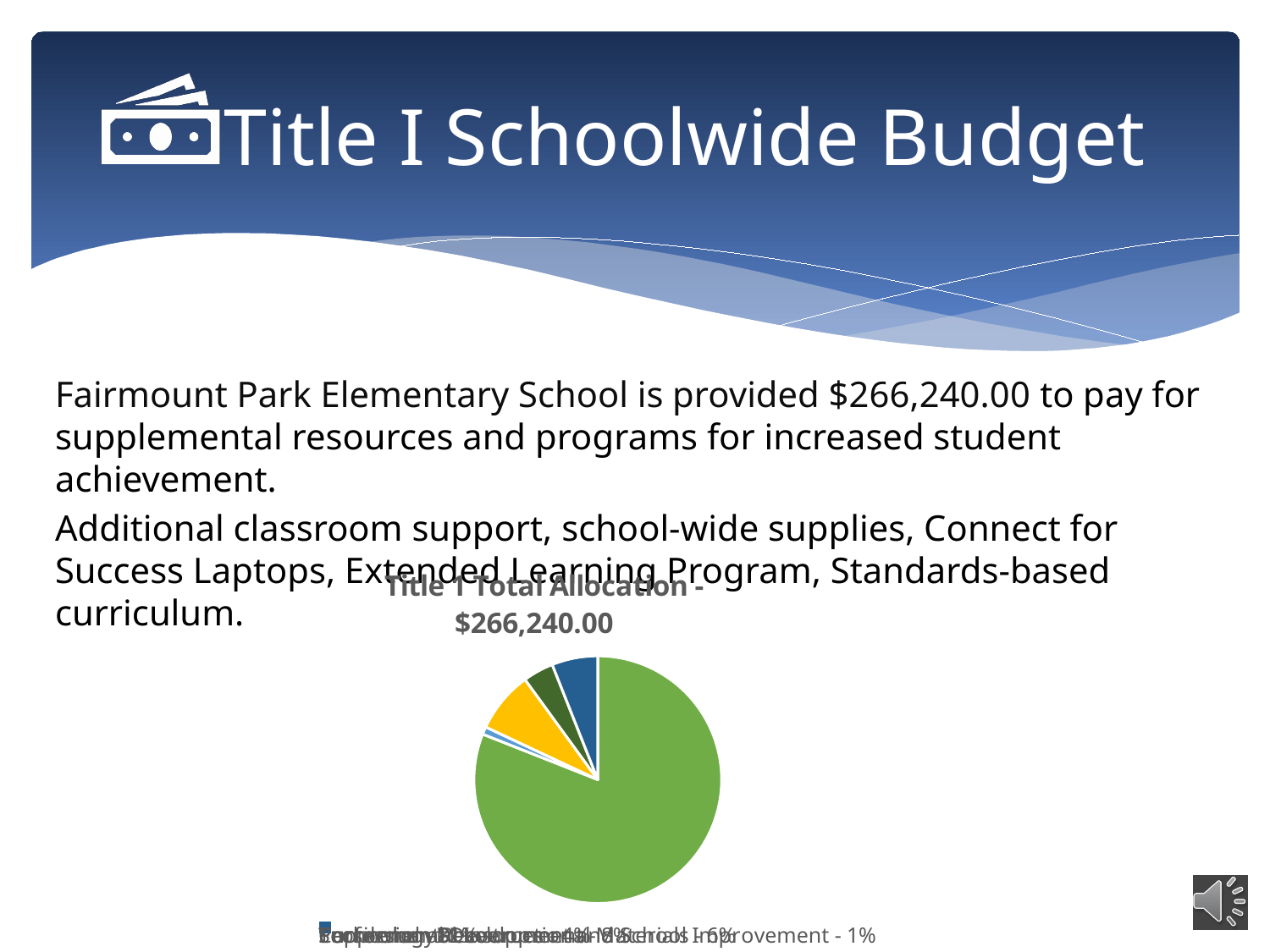
Does the green slice take up more or less than half of the pie chart? more Which colour slice is the largest in the pie chart? green Which colour slice is the smallest in the pie chart? light blue How many slices does the pie chart have? 5 What is the title of the pie chart? Title 1 Total Allocation - $266,240.00 What kind of chart is shown on the slide? pie chart Which slice is larger in the pie chart, the yellow slice or the dark blue slice? yellow